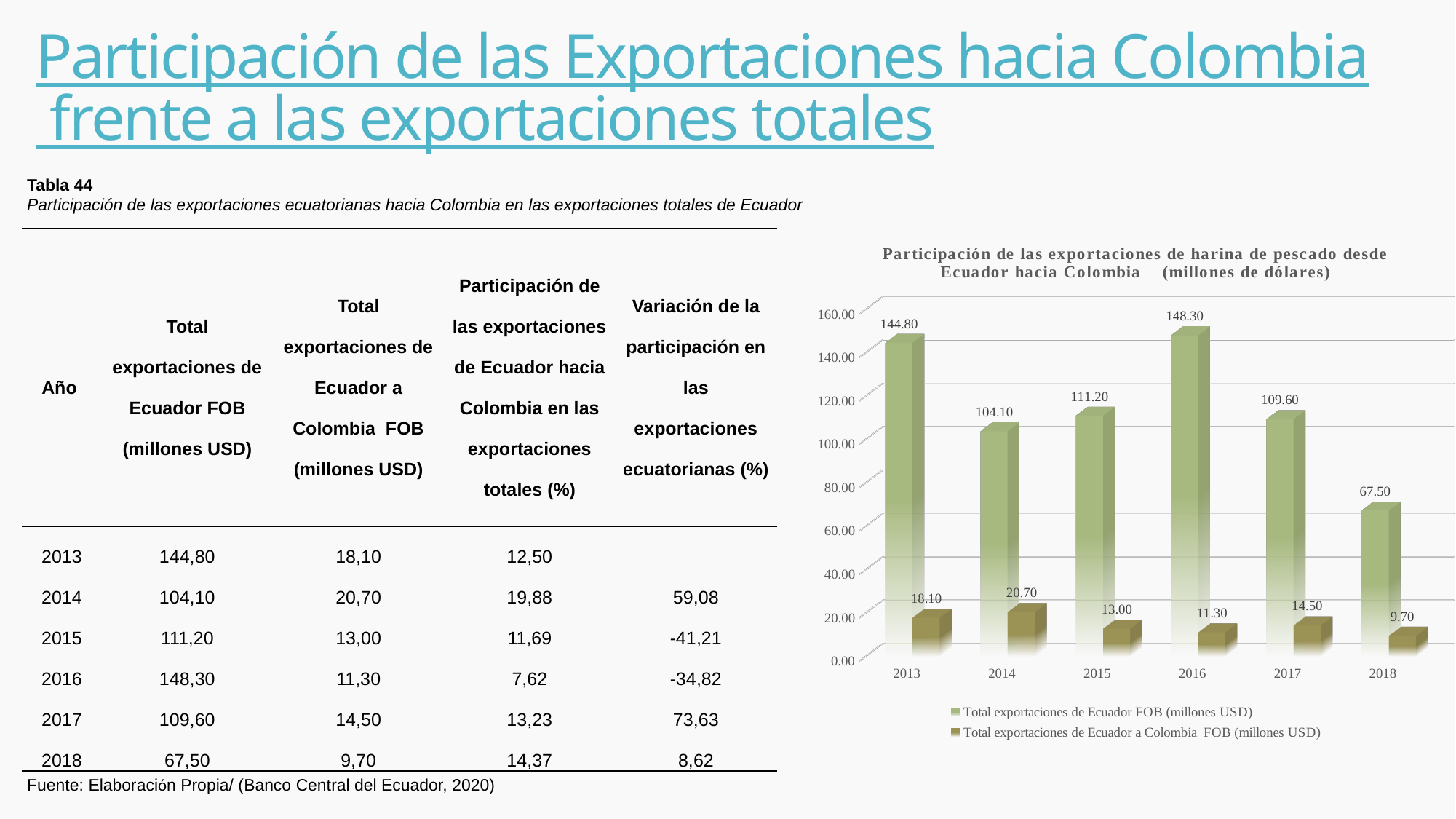
How many series does the chart legend list? 2 What is the value of Total exportaciones de Ecuador FOB (millones USD) for 2016? 148.30 What is the value of Total exportaciones de Ecuador a Colombia FOB (millones USD) for 2014? 20.70 Does the Total exportaciones de Ecuador a Colombia FOB series rise or fall from 2017 to 2018? fall Which is larger: Total exportaciones de Ecuador a Colombia FOB in 2015 or in 2017? 2017 Which year has the highest value for Total exportaciones de Ecuador FOB (millones USD)? 2016 What is the title of the chart? Participación de las exportaciones de harina de pescado desde Ecuador hacia Colombia (millones de dólares) What is the difference between the Total exportaciones de Ecuador FOB values for 2013 and 2018? 77.30 Which year has the lowest value for Total exportaciones de Ecuador a Colombia FOB (millones USD)? 2018 Is the value for Total exportaciones de Ecuador FOB in 2018 greater or less than 80.00? less What kind of chart is shown on the slide? bar chart How many years are shown on the x axis of the chart? 6